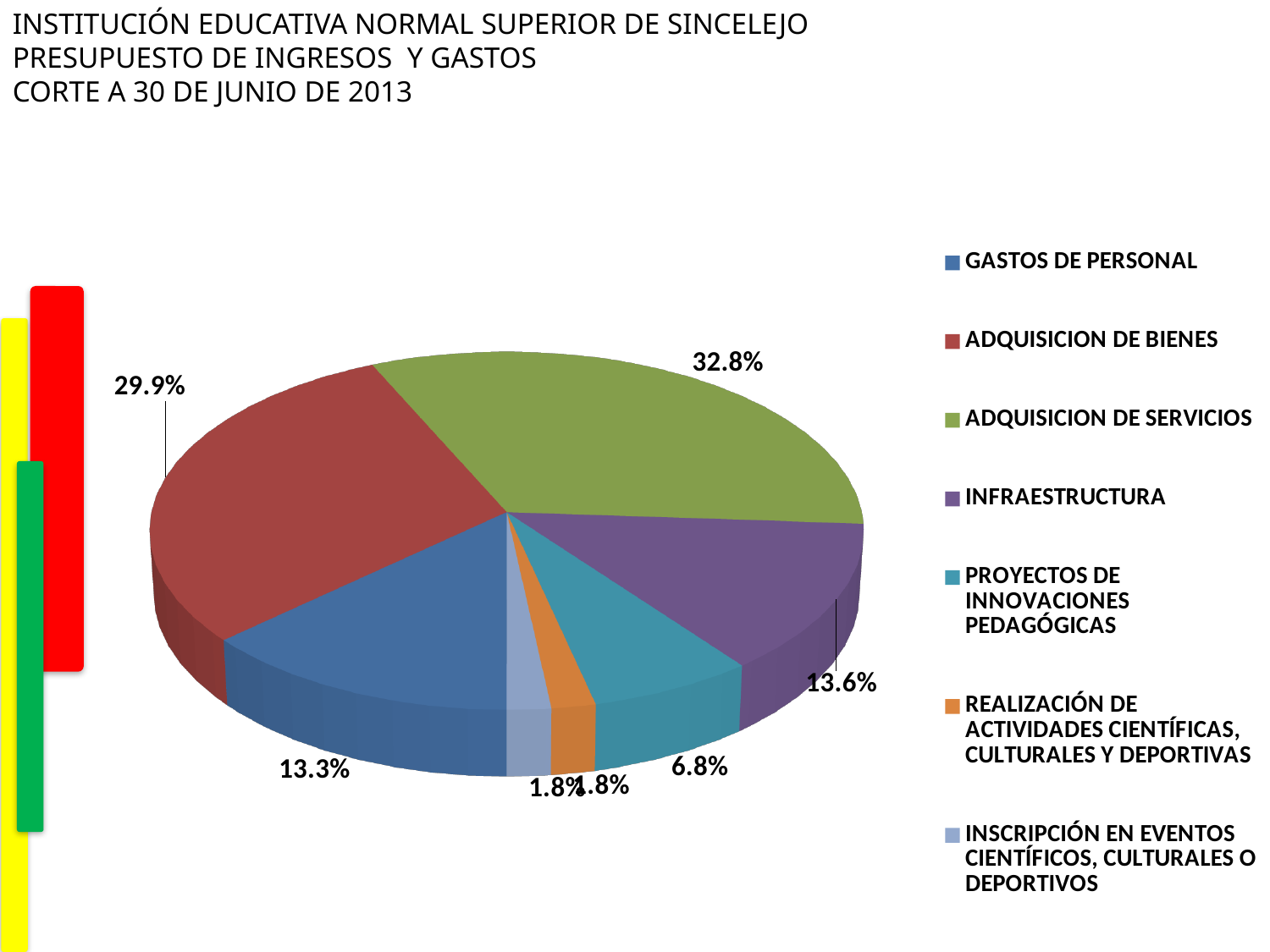
What is the value shown for INFRAESTRUCTURA? 13.6% How many entries does the legend list? 7 Which is larger, the share for ADQUISICION DE BIENES or the share for INFRAESTRUCTURA? ADQUISICION DE BIENES What is the value shown for PROYECTOS DE INNOVACIONES PEDAGÓGICAS? 6.8% How many slices does the pie chart have? 7 What share of the pie does ADQUISICION DE SERVICIOS represent? 32.8% What share of the pie does ADQUISICION DE BIENES represent? 29.9% What is the value shown for GASTOS DE PERSONAL? 13.3% Which category has the largest share of the pie? ADQUISICION DE SERVICIOS What kind of chart is shown on the slide? pie chart What is the difference between the shares of ADQUISICION DE SERVICIOS and ADQUISICION DE BIENES? 2.9% What is the smallest percentage shown on the pie chart? 1.8%